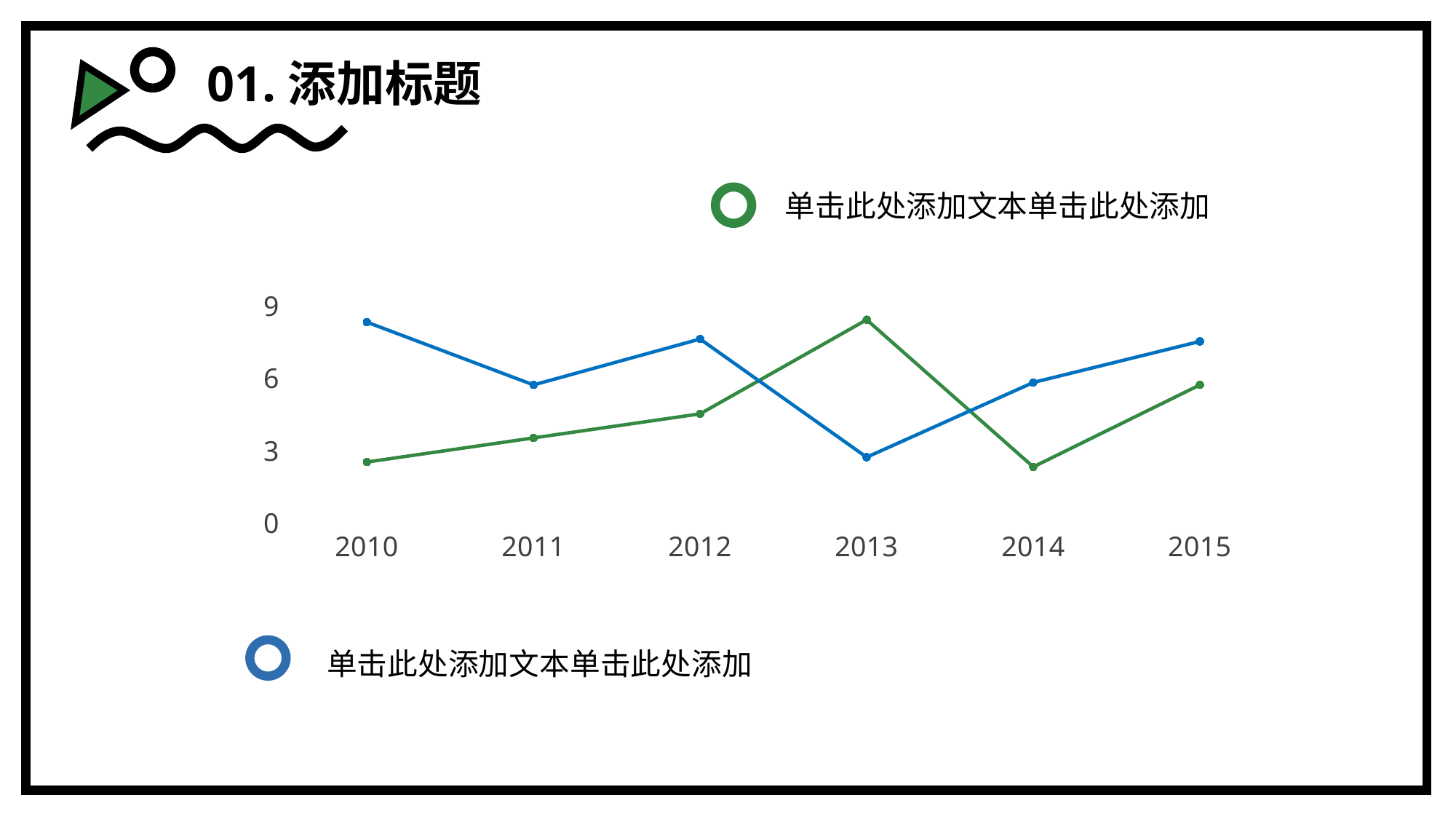
Is the value of the blue line in 2010 greater or less than 6? greater What kind of chart is shown on the slide? line chart In 2013, which line has the higher value, the blue line or the green line? the green line Is the value of the green line in 2012 greater or less than 6? less In which year does the green line reach its highest value? 2013 How many years are shown on the x axis of the chart? 6 Is the value of the green line in 2013 greater or less than 6? greater In 2015, which line has the higher value, the blue line or the green line? the blue line Does the green line rise or fall from 2010 to 2013? rise In which year does the blue line reach its highest value? 2010 In which year does the blue line reach its lowest value? 2013 How many lines are plotted in the chart? 2